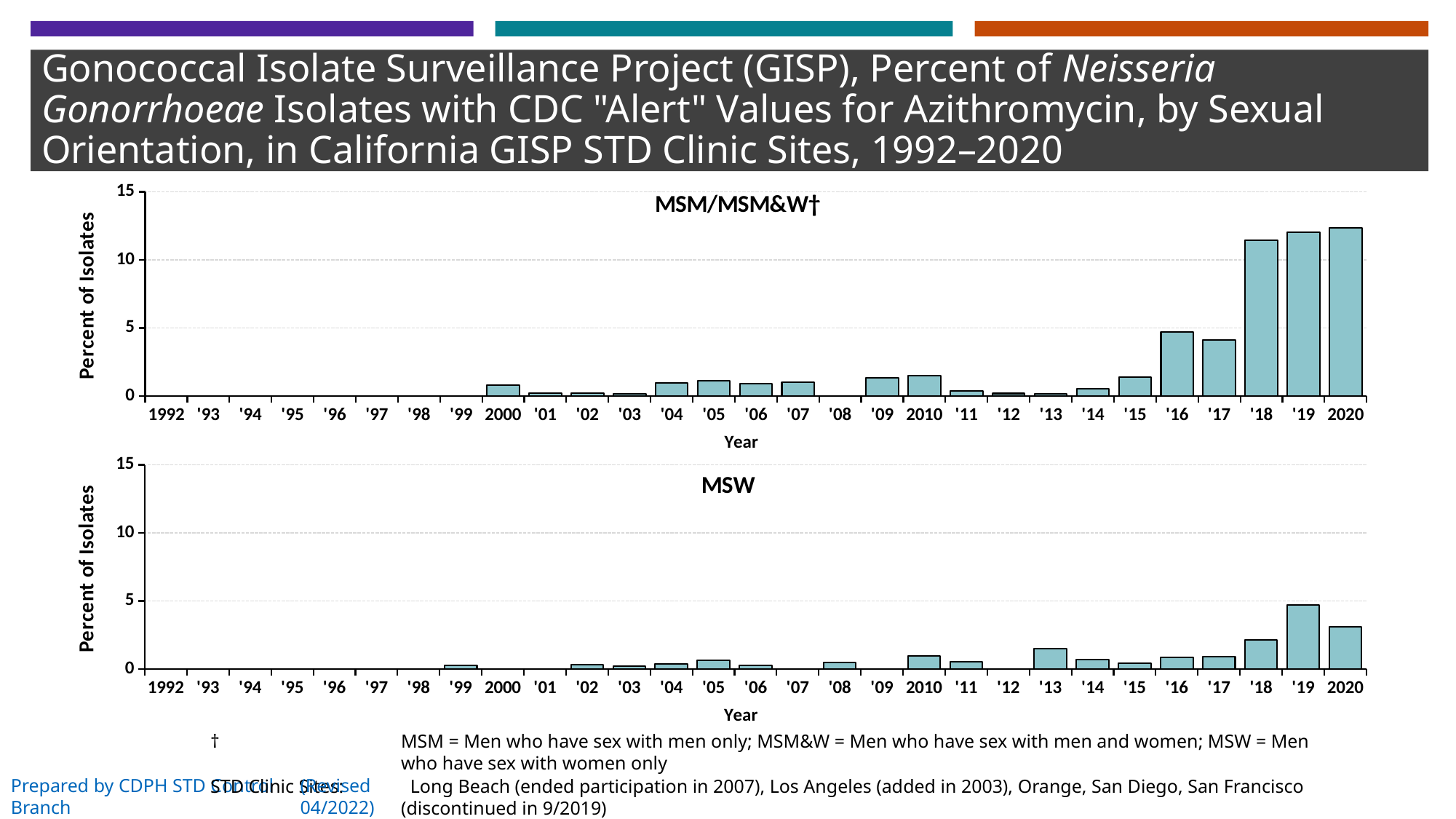
In the bottom chart (MSW), which is larger, the value for '19 or the value for '13? '19 In the top chart (MSM/MSM&W†), do the values generally rise or fall from '15 to 2020? rise In the top chart (MSM/MSM&W†), which year has the highest percent of isolates? 2020 In the top chart (MSM/MSM&W†), is the value for '18 greater or less than 10? greater How many years are shown on the x axis of the top chart (MSM/MSM&W†)? 29 In the bottom chart (MSW), which year has the highest percent of isolates? '19 In the top chart (MSM/MSM&W†), which is larger, the value for '18 or the value for '15? '18 What is the y-axis label on the bottom chart (MSW)? Percent of Isolates What kind of chart is the top chart titled MSM/MSM&W†? bar chart In the bottom chart (MSW), is the value for 2020 greater or less than 5? less